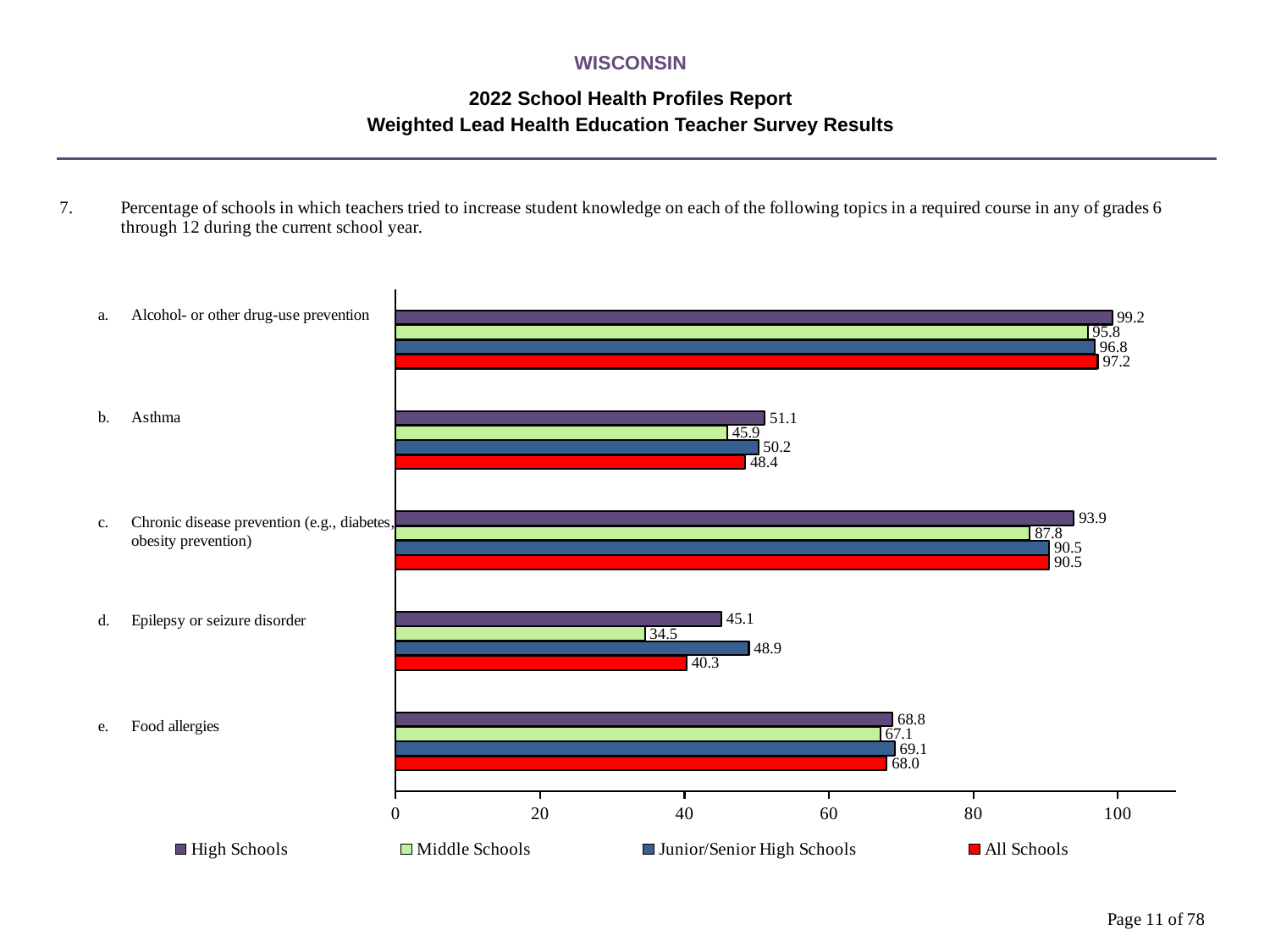
What is the value for All Schools for Epilepsy or seizure disorder? 40.3 Which series is shown in red in the legend? All Schools How many series does the legend list? 4 For Asthma, which is larger: the High Schools value or the Junior/Senior High Schools value? High Schools What is the value for Junior/Senior High Schools for Food allergies? 69.1 Which topic has the highest value for All Schools? Alcohol- or other drug-use prevention What is the value for Middle Schools for Asthma? 45.9 What is the value for High Schools for Alcohol- or other drug-use prevention? 99.2 How many topics are shown on the chart? 5 What is the difference between the High Schools and Middle Schools values for Epilepsy or seizure disorder? 10.6 What kind of chart is shown on the slide? Bar chart Which topic has the lowest value for Middle Schools? Epilepsy or seizure disorder